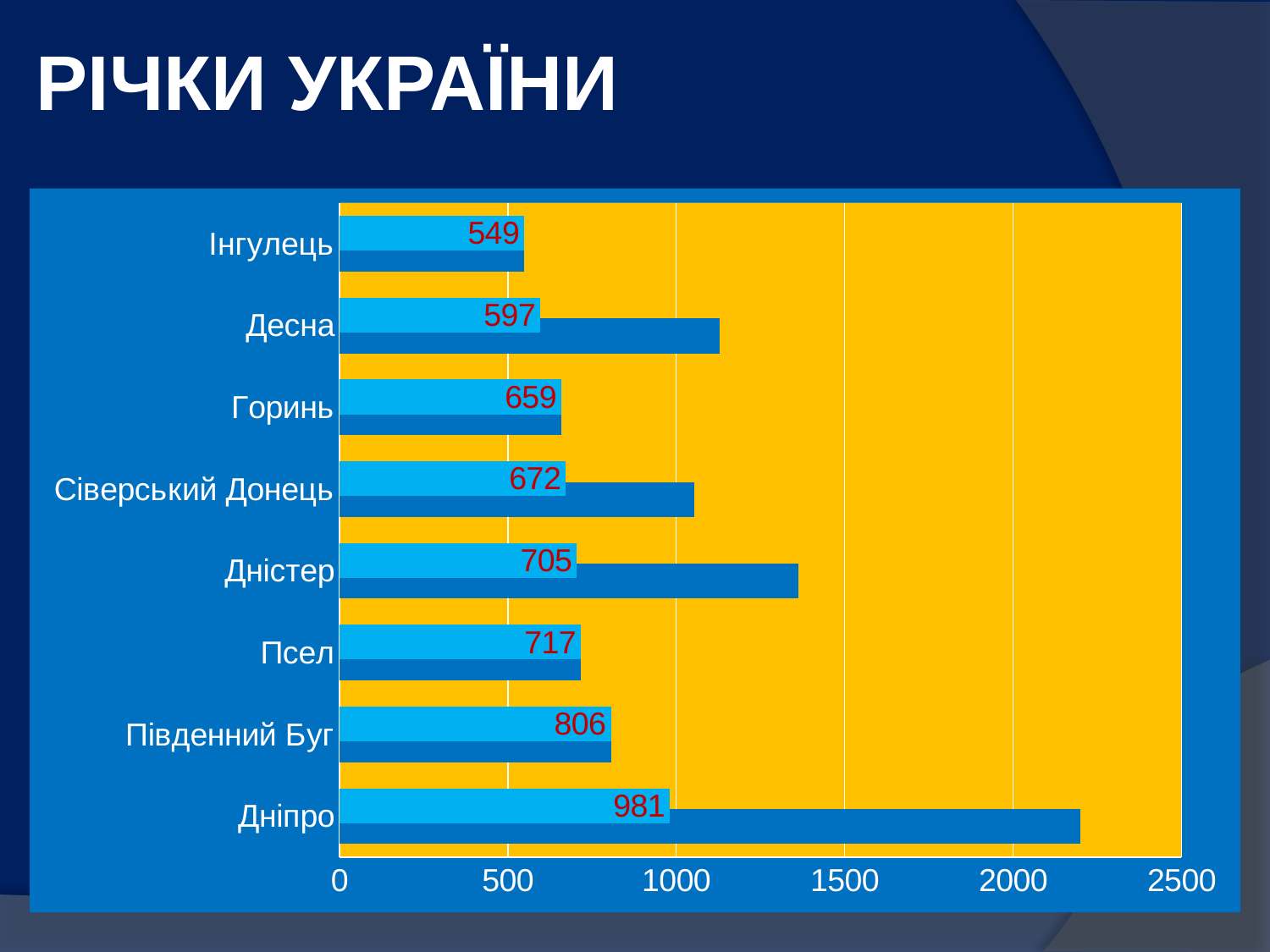
Is the value of the unlabelled dark blue bar for Дніпро greater or less than 2000? greater What is the difference between the labelled values for Дніпро and Інгулець? 432 What is the difference between the labelled values for Південний Буг and Псел? 89 What type of chart is shown on the slide? Bar chart What is the labelled value for Дніпро? 981 Is the value of the unlabelled dark blue bar for Дністер greater or less than 1500? less What is the labelled value for Південний Буг? 806 How many rivers are shown on the chart? 8 Which river has the lowest labelled value? Інгулець What is the labelled value for Сіверський Донець? 672 Which river has the highest labelled value? Дніпро Which has the larger labelled value, Десна or Горинь? Горинь